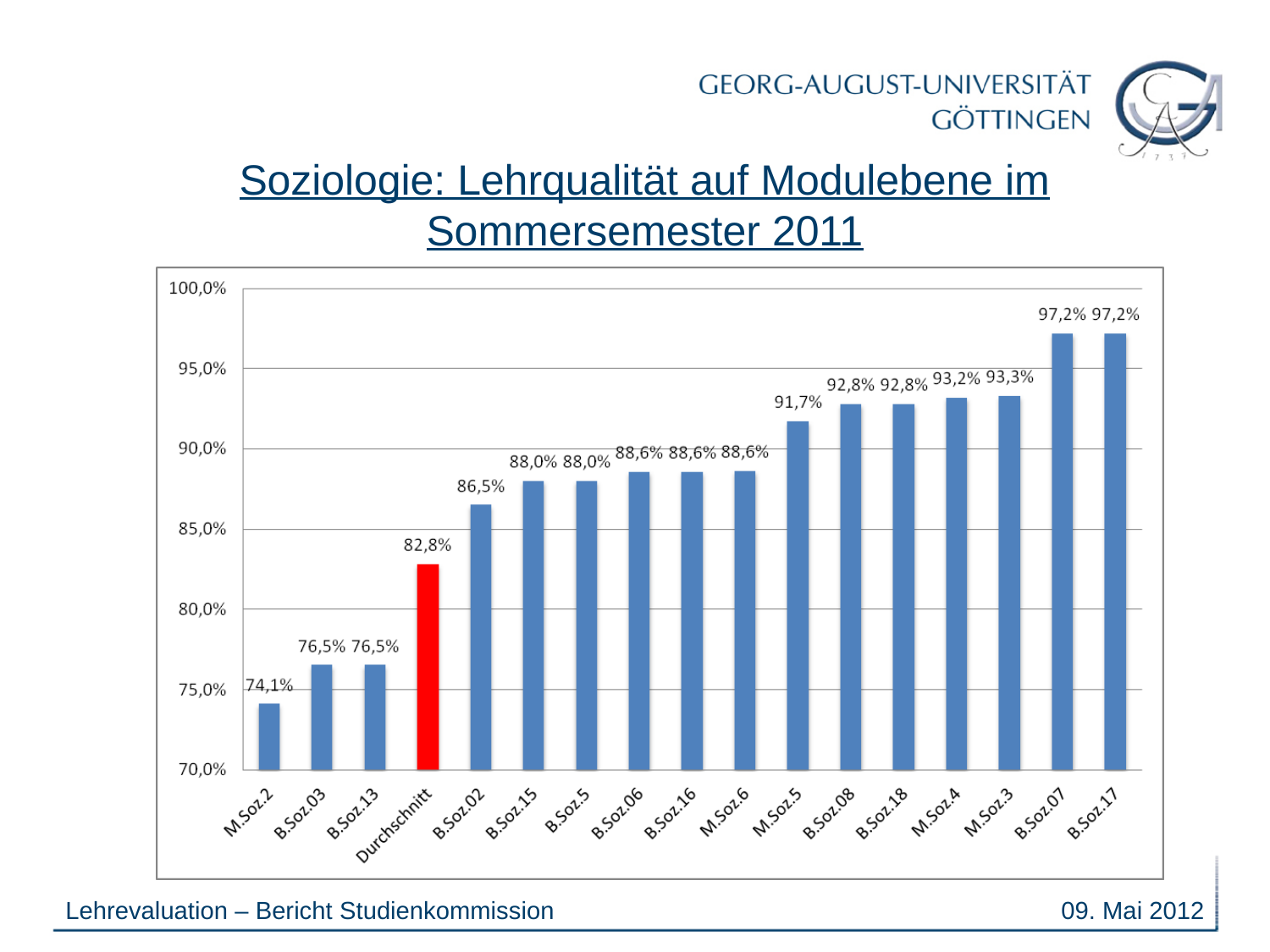
What is the difference between the values for B.Soz.07 and Durchschnitt? 14,4% Which is larger, the value for M.Soz.3 or the value for M.Soz.5? M.Soz.3 What kind of chart is shown on the slide? bar chart What is the value for B.Soz.17? 97,2% Which category has the lowest value? M.Soz.2 Is the value for B.Soz.13 greater or less than 80,0%? less What is the value for M.Soz.2? 74,1% What is the value for M.Soz.5? 91,7% How many categories are shown on the x axis? 17 What is the value for B.Soz.02? 86,5% What is the value for Durchschnitt? 82,8% Which bar is coloured red instead of blue? Durchschnitt